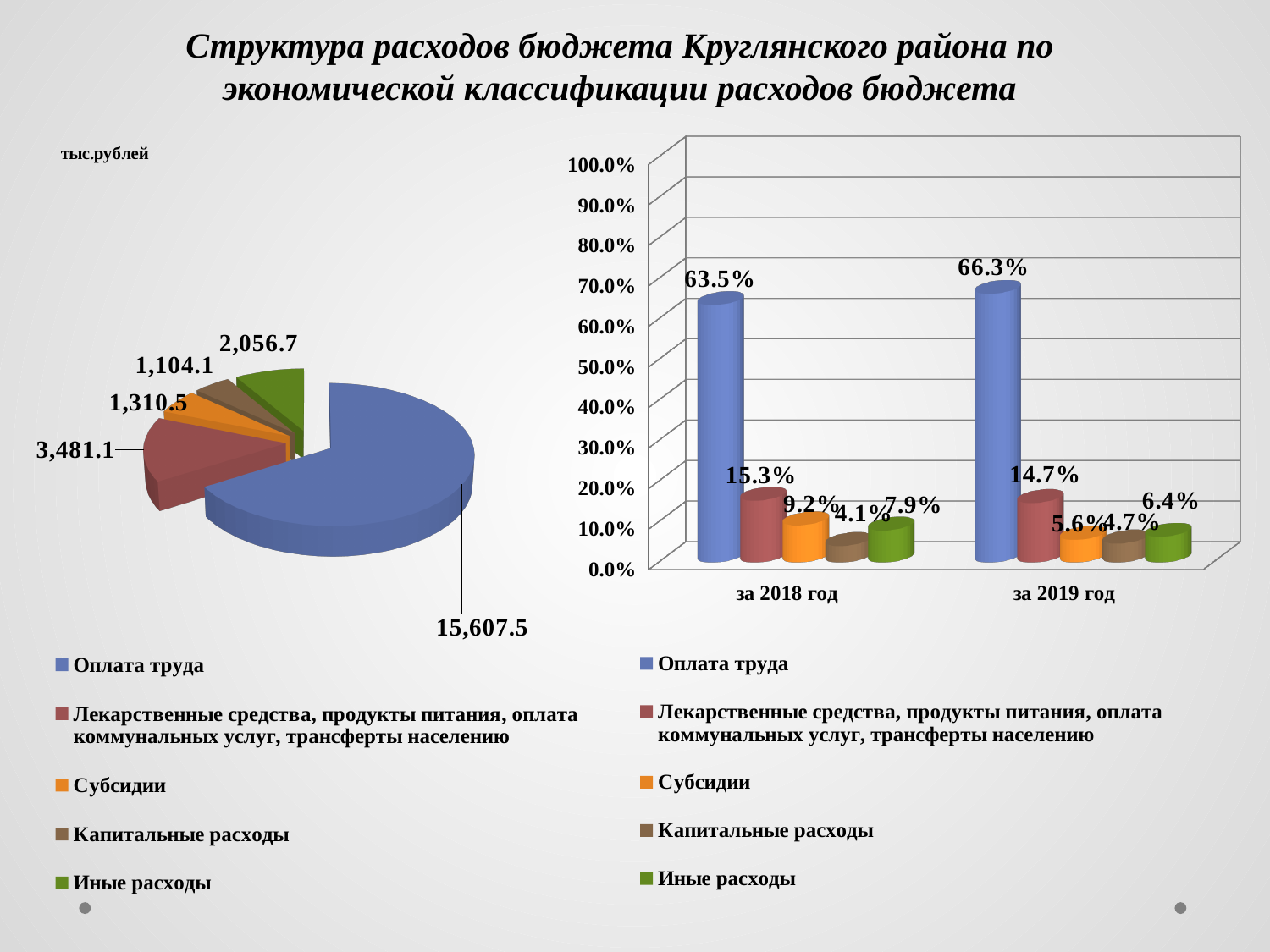
How many slices does the left pie chart have? 5 On the right bar chart, what is the value for Субсидии за 2018 год? 9.2% On the left pie chart, what is the value for Иные расходы? 2,056.7 On the right bar chart, which series has the lowest value за 2019 год? Капитальные расходы On the left pie chart, which is larger: Иные расходы or Субсидии? Иные расходы On the right bar chart, what is the difference between the Оплата труда values for 2019 and 2018? 2.8% On the right bar chart, what is the value for Оплата труда за 2019 год? 66.3% On the left pie chart, what is the value for Оплата труда? 15,607.5 On the left pie chart, what is the difference between the values for Субсидии and Капитальные расходы? 206.4 How many series does the legend of the right bar chart list? 5 On the left pie chart, which category has the smallest value? Капитальные расходы What type of chart is shown on the right side of the slide? Bar chart